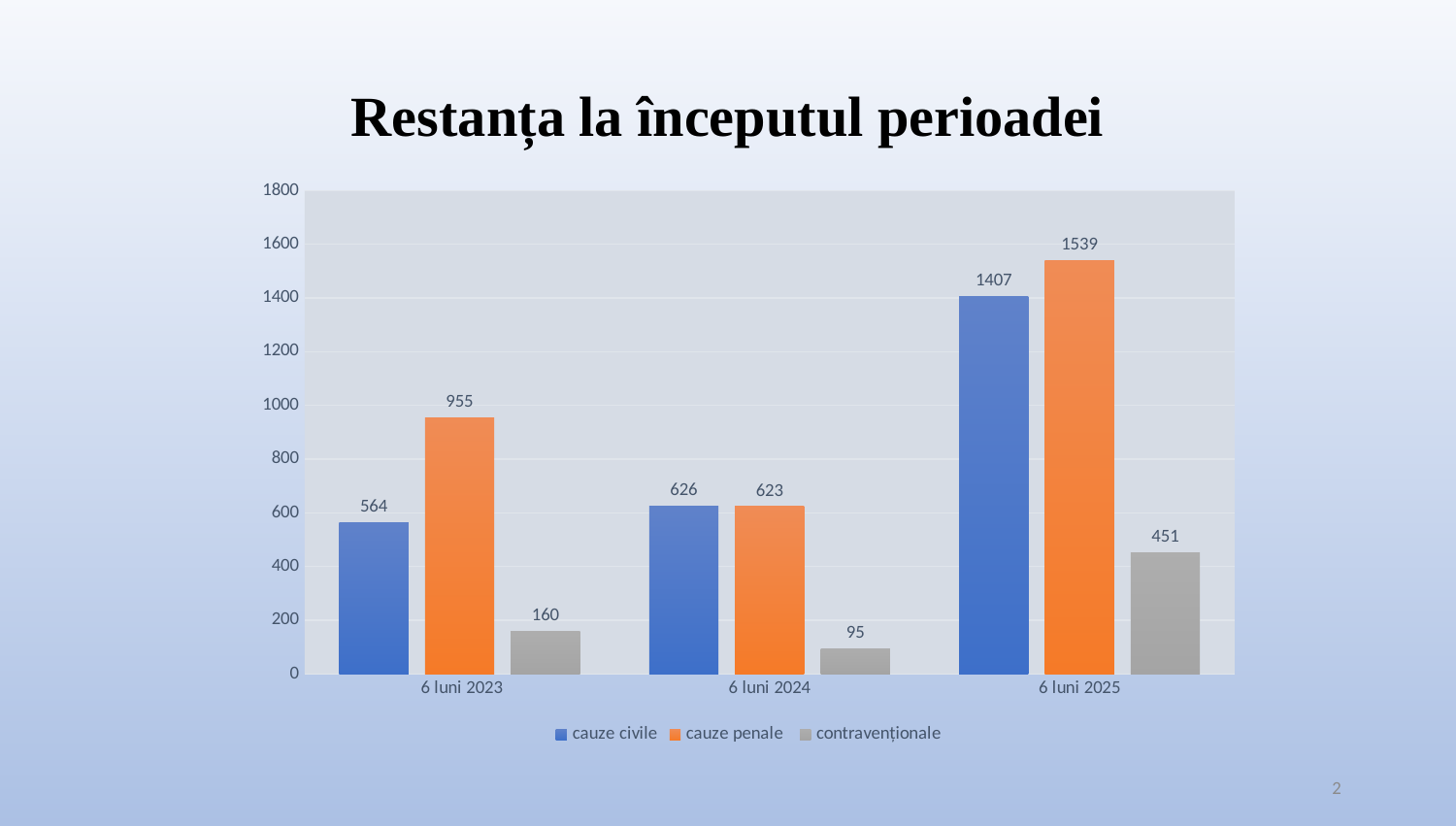
Which is larger in 6 luni 2023: cauze civile or cauze penale? cauze penale Which period has the lowest value for contravenționale? 6 luni 2024 What kind of chart is shown on the slide? bar chart How many series does the legend list? 3 What is the value for cauze penale in 6 luni 2023? 955 Is the value for cauze civile in 6 luni 2024 greater or less than 800? less What is the value for cauze civile in 6 luni 2025? 1407 What is the value for contravenționale in 6 luni 2024? 95 What is the title of the chart? Restanța la începutul perioadei How many periods are shown on the x axis? 3 What is the difference between cauze penale and cauze civile in 6 luni 2025? 132 Which period has the highest value for cauze penale? 6 luni 2025